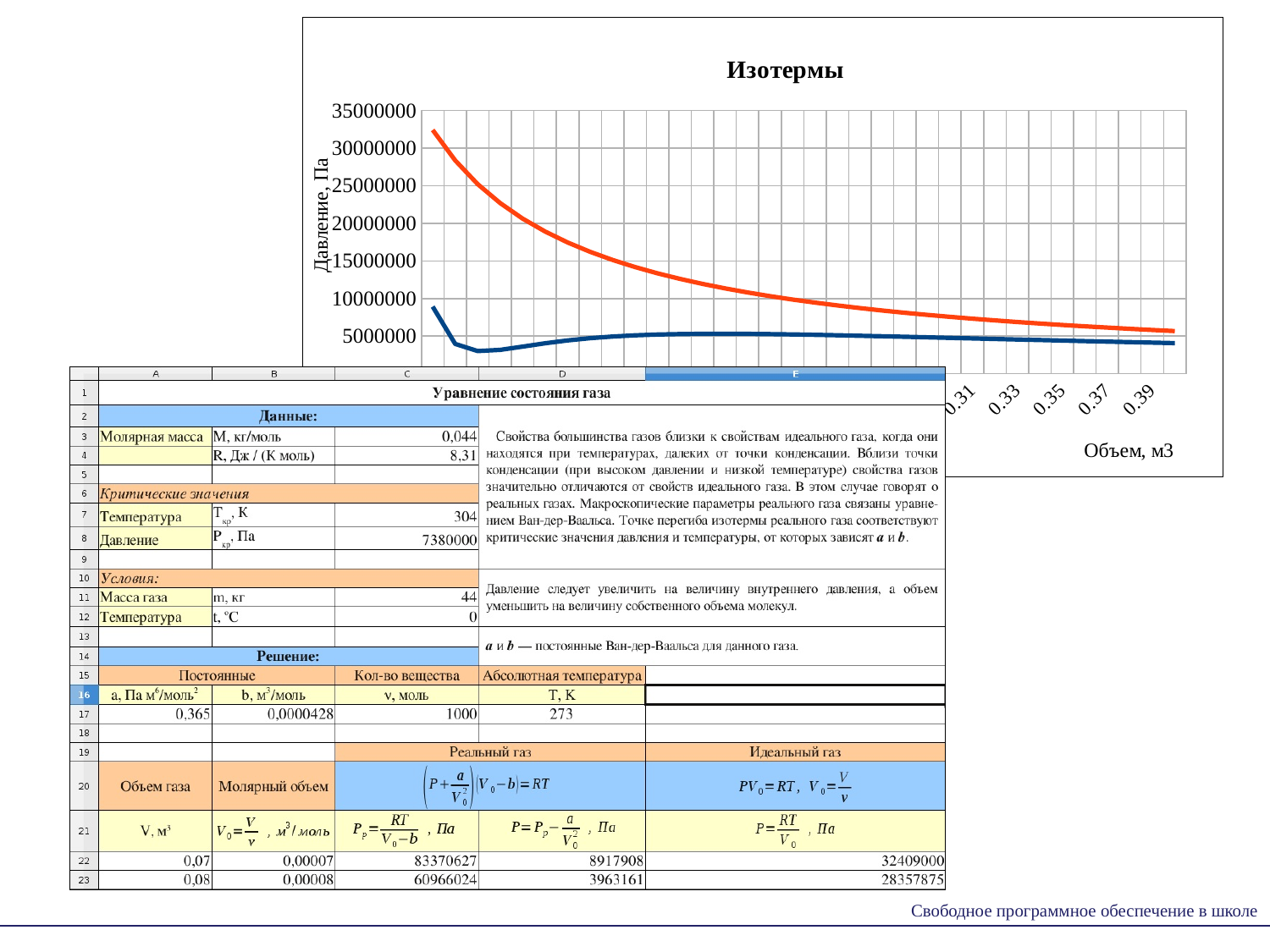
Is the starting value of the orange line at the left of the chart greater or less than 30000000? greater Is the starting value of the dark blue line at the left of the chart greater or less than 10000000? less What is the title of the chart? Изотермы Is the lowest point of the dark blue line greater or less than 5000000? less Which line lies higher on the chart, the orange line or the dark blue line? the orange line What kind of chart is shown on the slide? line chart How many lines are plotted on the chart? 2 What is the label of the vertical axis of the chart? Давление, Па What is the highest tick value shown on the vertical axis? 35000000 Does the orange line rise or fall as volume increases along the x axis? fall